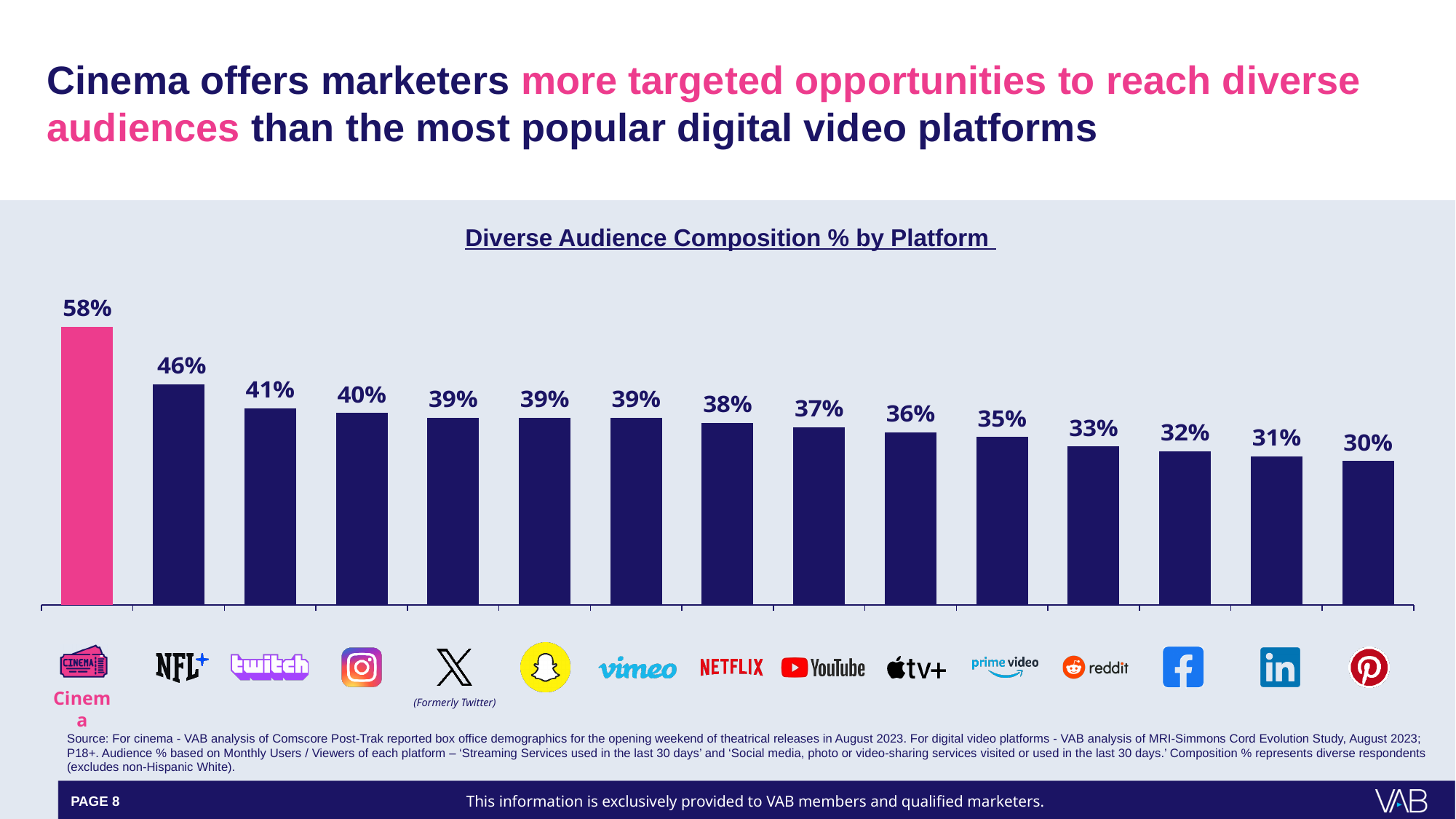
Which platform has the lowest value on the chart? Pinterest Which platform has the highest diverse audience composition %? Cinema What is the diverse audience composition % for Cinema? 58% How many platforms are shown on the chart? 15 What is the difference between the values for Vimeo and Reddit? 6% What is the value shown for Netflix? 38% What is the value shown for Twitch? 41% Which has a larger value, Prime Video or Apple TV+? Apple TV+ What type of chart is shown on the slide? Bar chart What is the difference between the values for Cinema and NFL+? 12% What is the title of the chart? Diverse Audience Composition % by Platform What is the value shown for YouTube? 37%